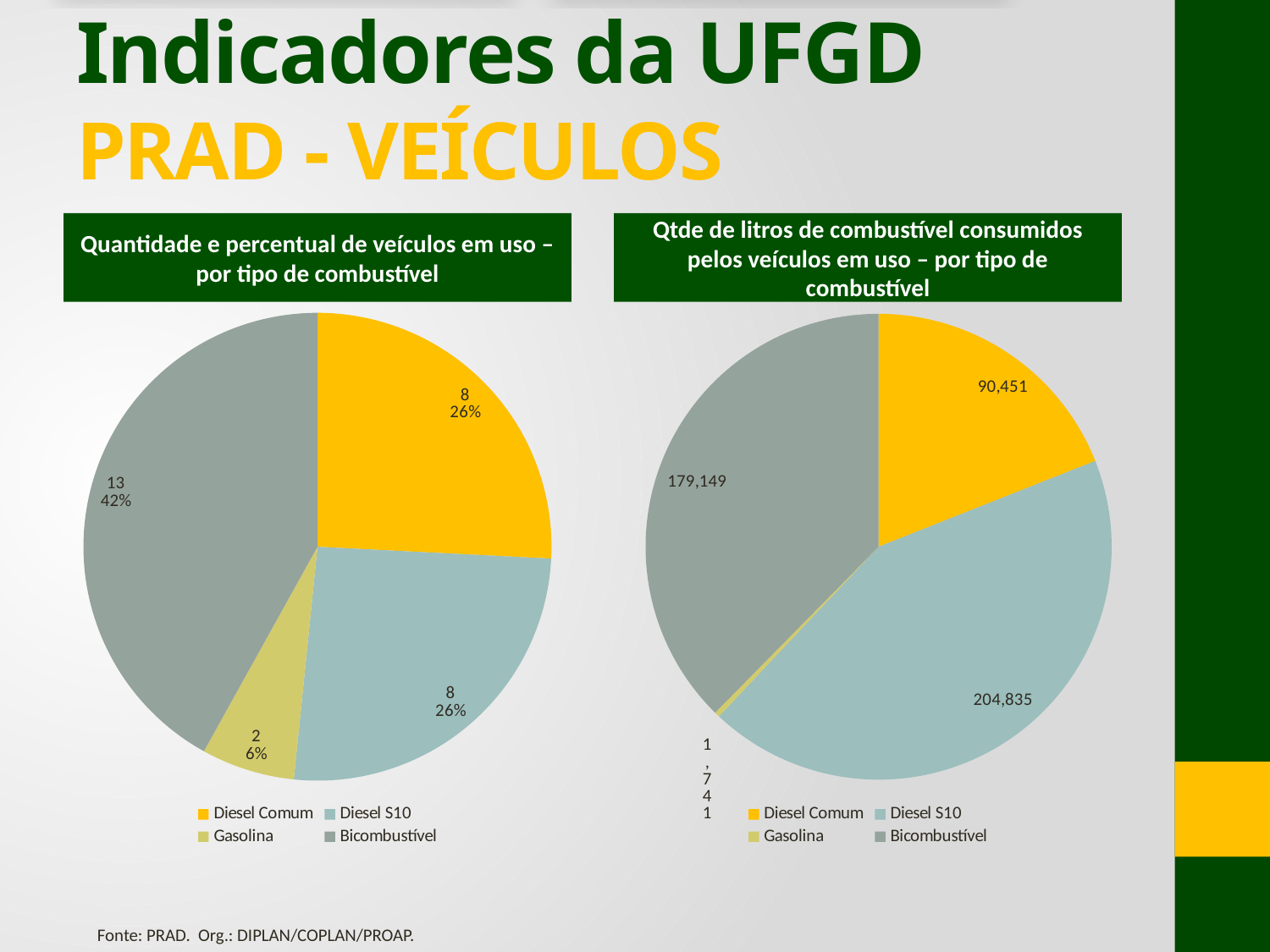
In the left chart (Quantidade e percentual de veículos em uso), what percentage of vehicles use Gasolina? 6% In the left chart (Quantidade e percentual de veículos em uso), which fuel type has the fewest vehicles? Gasolina In the left chart (Quantidade e percentual de veículos em uso), which fuel type has the largest number of vehicles? Bicombustível In the right chart (Qtde de litros de combustível consumidos), which is larger: the litres of Bicombustível or the litres of Diesel Comum? Bicombustível What type of chart is used for both charts on the slide? Pie chart In the left chart (Quantidade e percentual de veículos em uso), how many vehicles use Bicombustível? 13 In the left chart (Quantidade e percentual de veículos em uso), how many more vehicles use Bicombustível than Gasolina? 11 In the right chart (Qtde de litros de combustível consumidos), what is the difference in litres between Diesel S10 and Bicombustível? 25,686 In the right chart (Qtde de litros de combustível consumidos), how many litres of Diesel S10 were consumed? 204,835 In the right chart (Qtde de litros de combustível consumidos), which fuel type had the highest consumption in litres? Diesel S10 In the right chart (Qtde de litros de combustível consumidos), how many litres of Diesel Comum were consumed? 90,451 In the left chart (Quantidade e percentual de veículos em uso), what percentage of vehicles use Diesel Comum? 26%